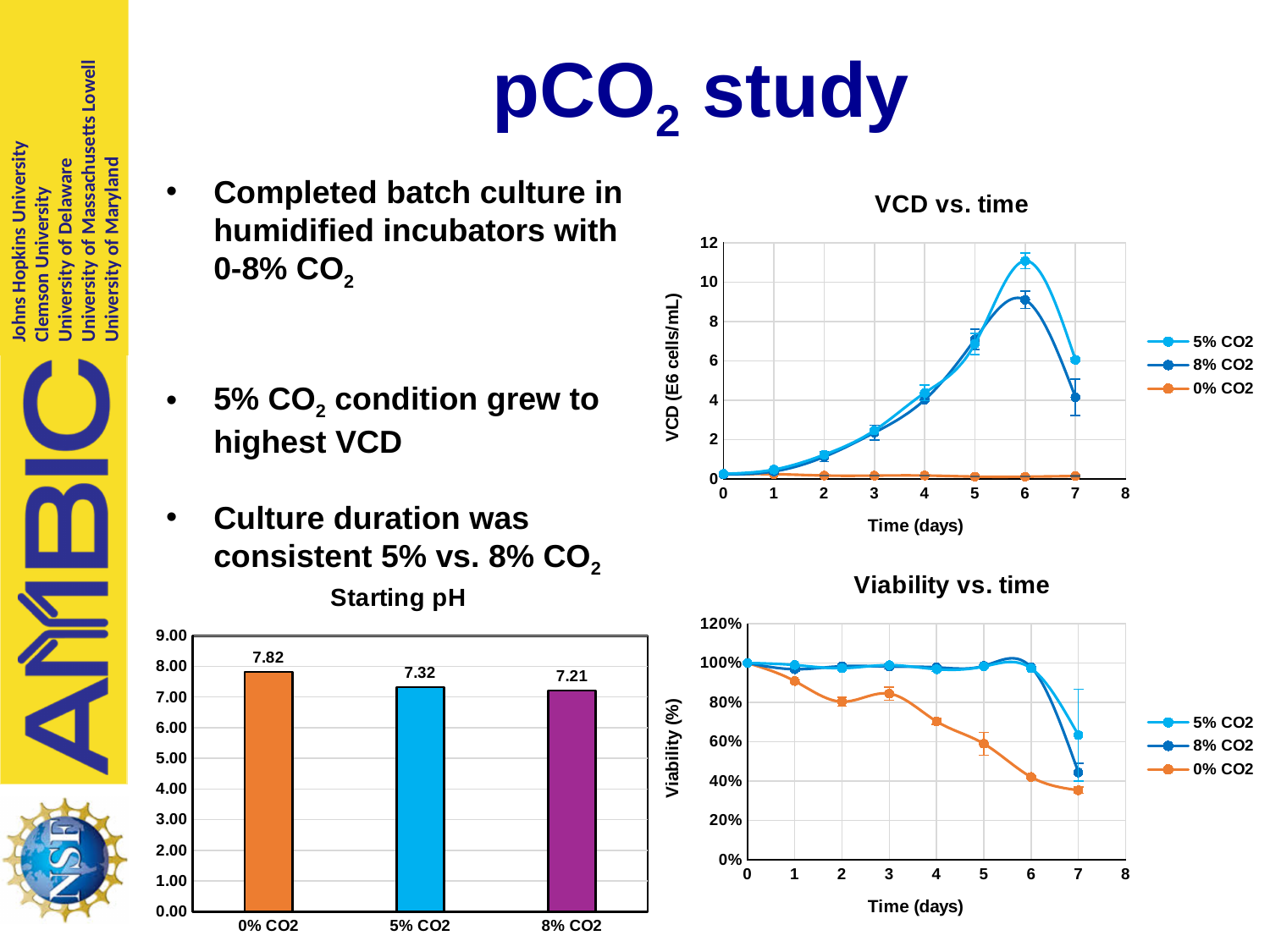
In the "VCD vs. time" chart, is the value for 5% CO2 at day 6 greater or less than 10? greater In the "Viability vs. time" chart, is the value for 0% CO2 at day 7 greater or less than 40%? less In the "Starting pH" chart, how many categories are shown? 3 In the "Starting pH" chart, which category has the lowest value? 8% CO2 In the "VCD vs. time" chart, which series reaches the highest VCD? 5% CO2 In the "Starting pH" chart, what is the difference between the values for 0% CO2 and 5% CO2? 0.50 In the "Starting pH" chart, which category has the highest value? 0% CO2 In the "VCD vs. time" chart, how many series does the legend list? 3 What kind of chart is the "Starting pH" chart? bar chart In the "Starting pH" chart, what is the value for 0% CO2? 7.82 In the "Starting pH" chart, what is the value for 8% CO2? 7.21 In the "Viability vs. time" chart, what is the label of the y axis? Viability (%)